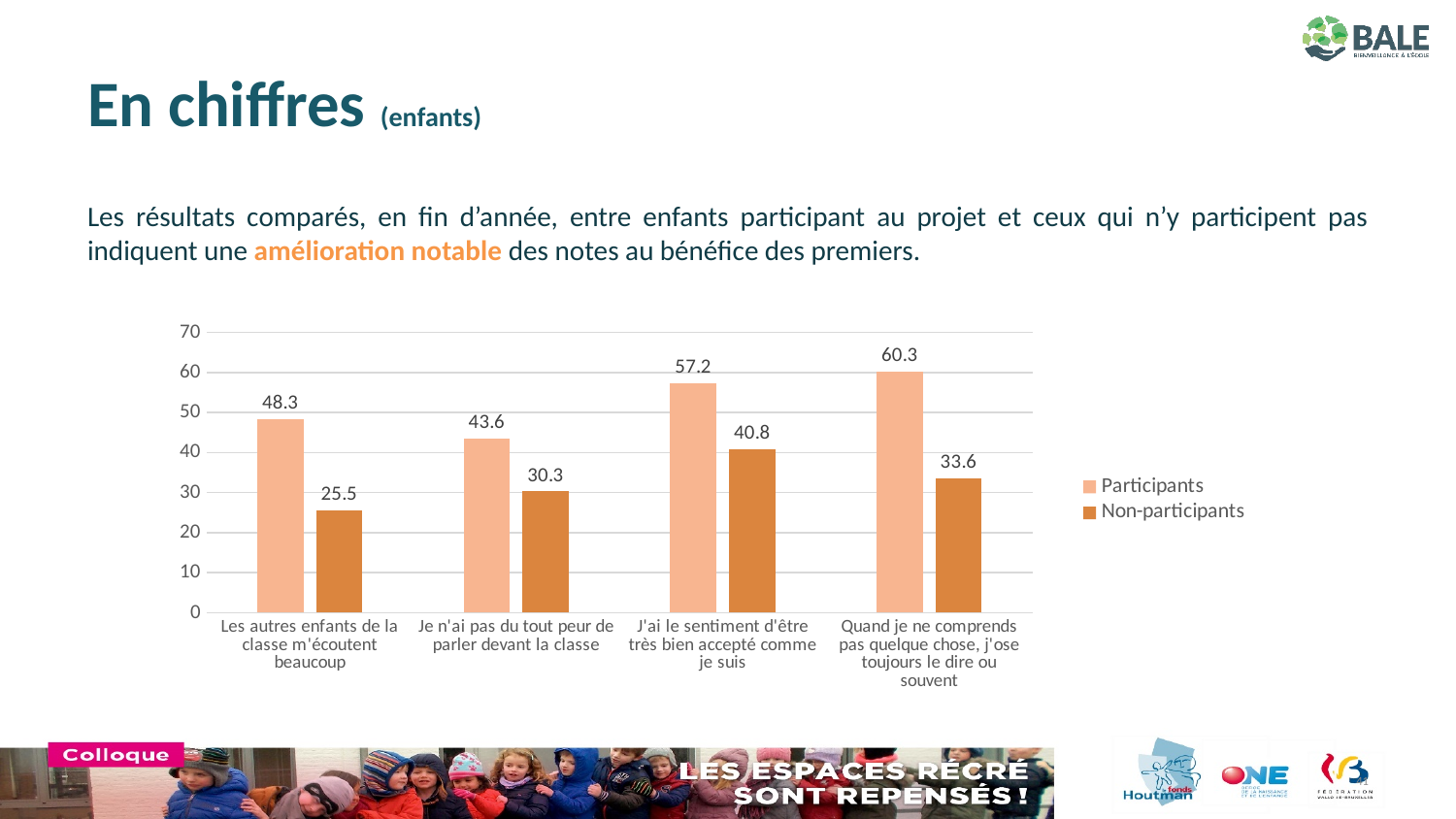
Is the value for Participants for "J'ai le sentiment d'être très bien accepté comme je suis" greater or less than 50? greater What kind of chart is shown on the slide? bar chart How many categories are shown on the x axis? 4 Which category has the highest value for Participants? Quand je ne comprends pas quelque chose, j'ose toujours le dire ou souvent What is the value for Participants for "Les autres enfants de la classe m'écoutent beaucoup"? 48.3 What is the value for Non-participants for "Je n'ai pas du tout peur de parler devant la classe"? 30.3 What is the difference between Participants and Non-participants for "Quand je ne comprends pas quelque chose, j'ose toujours le dire ou souvent"? 26.7 Which is larger for "Je n'ai pas du tout peur de parler devant la classe": Participants or Non-participants? Participants What is the value for Non-participants for "J'ai le sentiment d'être très bien accepté comme je suis"? 40.8 How many series does the legend list? 2 What are the two series named in the legend? Participants and Non-participants Which category has the lowest value for Non-participants? Les autres enfants de la classe m'écoutent beaucoup